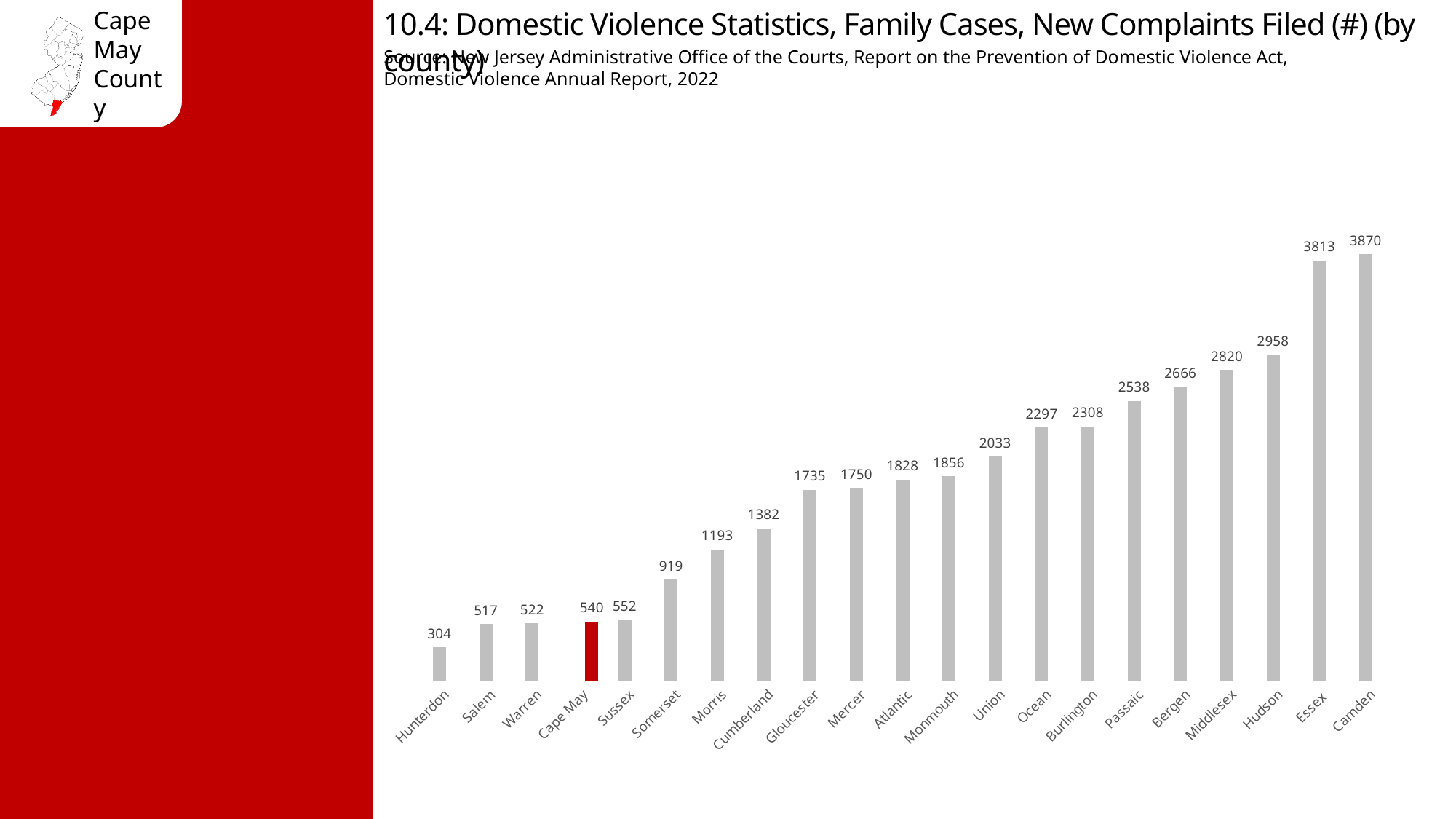
Which has a larger value, Morris or Somerset? Morris What is the value shown for Gloucester? 1735 What is the difference between the values for Cape May and Hunterdon? 236 How many counties are shown on the chart? 21 Which county has the highest number of new complaints filed? Camden What is the number of new domestic violence complaints filed for Cape May? 540 Which county's bar is highlighted in red? Cape May What is the value shown for Hudson? 2958 Which county has the lowest number of new complaints filed? Hunterdon Which has a larger value, Union or Ocean? Ocean What is the difference between the values for Camden and Essex? 57 What kind of chart is shown on the slide? Bar chart